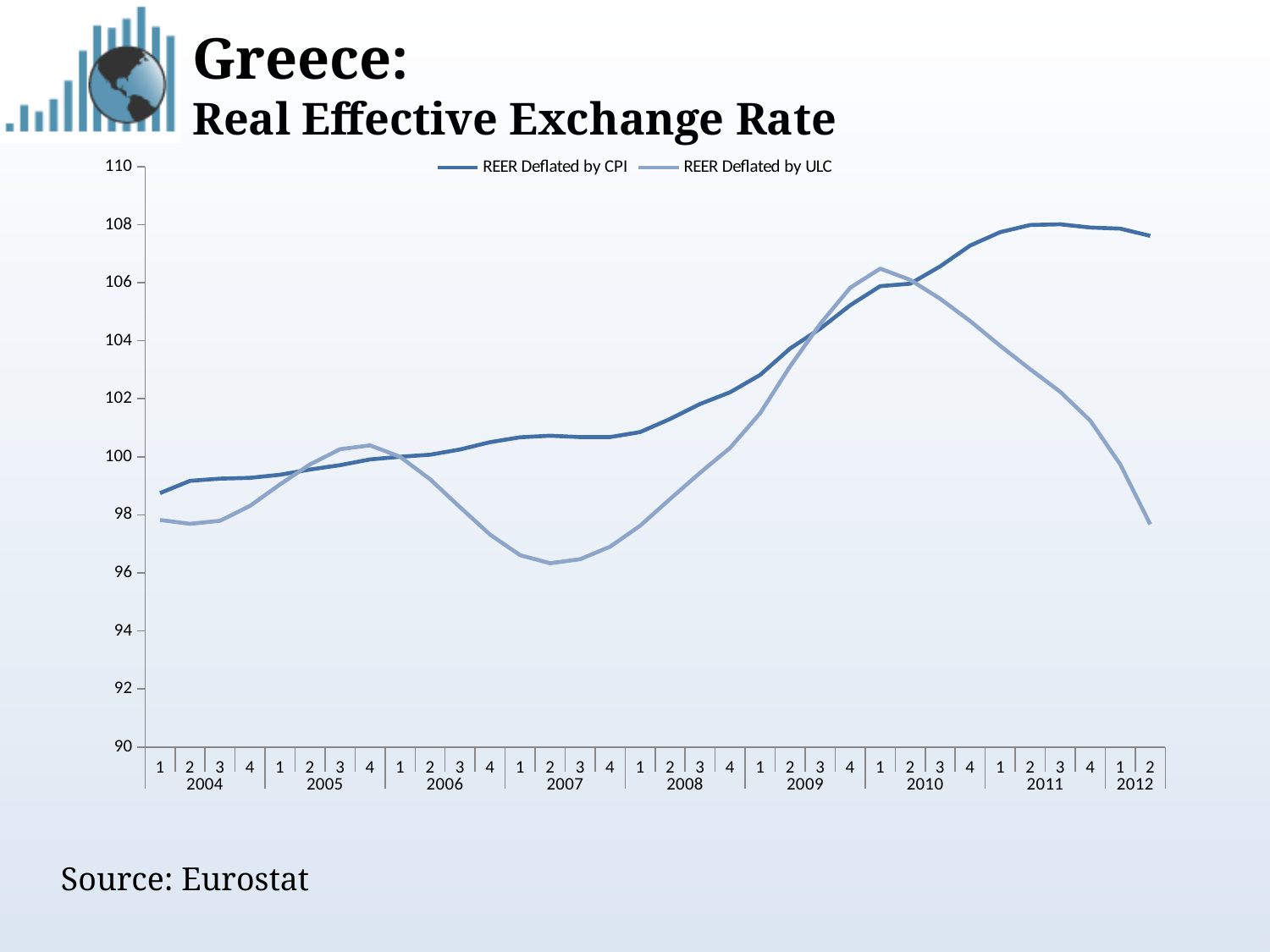
Is the value of REER Deflated by ULC in quarter 2 of 2007 greater or less than 98? less In quarter 1 of 2010, which series has the higher value, REER Deflated by CPI or REER Deflated by ULC? REER Deflated by ULC Is the value of REER Deflated by CPI in quarter 1 of 2004 greater or less than 100? less What kind of chart is shown on the slide? line chart Does REER Deflated by ULC rise or fall between quarter 1 of 2010 and quarter 2 of 2012? fall Which series reaches the higher peak value over the whole period? REER Deflated by CPI In quarter 2 of 2012, which series has the higher value, REER Deflated by CPI or REER Deflated by ULC? REER Deflated by CPI How many quarterly data points does each series cover, from 2004 Q1 to 2012 Q2? 34 What is the source cited for the chart data? Eurostat Is the value of REER Deflated by CPI in quarter 2 of 2012 greater or less than 106? greater How many series does the legend list? 2